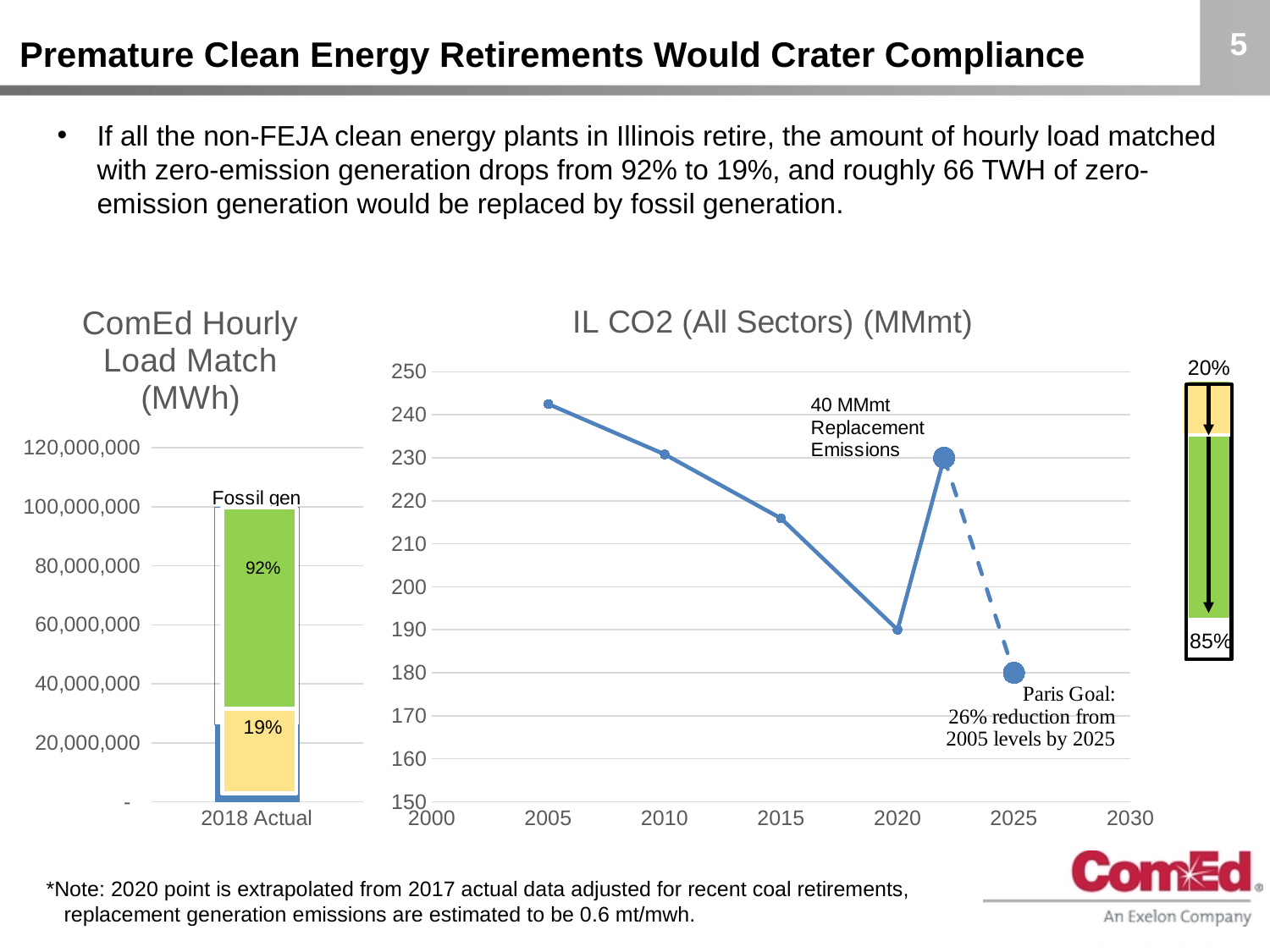
In the IL CO2 (All Sectors) (MMmt) chart, which year has the highest CO2 value? 2005 In the ComEd Hourly Load Match (MWh) chart, what percentage is labelled on the green segment of the 2018 Actual bar? 92% In the IL CO2 (All Sectors) (MMmt) chart, which year has the lowest CO2 value? 2025 In the IL CO2 (All Sectors) (MMmt) chart, is the value for 2015 greater or less than 210? greater In the IL CO2 (All Sectors) (MMmt) chart, do the values rise or fall from 2005 to 2020? fall In the IL CO2 (All Sectors) (MMmt) chart, is the value for 2020 greater or less than 200? less In the ComEd Hourly Load Match (MWh) chart, what percentage is labelled on the yellow segment of the 2018 Actual bar? 19% In the IL CO2 (All Sectors) (MMmt) chart, is the value for 2005 greater or less than 240? greater What kind of chart is the IL CO2 (All Sectors) (MMmt) chart? line chart How many categories are shown on the x axis of the ComEd Hourly Load Match (MWh) chart? 1 In the IL CO2 (All Sectors) (MMmt) chart, what amount of replacement emissions is noted in the annotation near the 2022 point? 40 MMmt What kind of chart is the ComEd Hourly Load Match (MWh) chart? bar chart